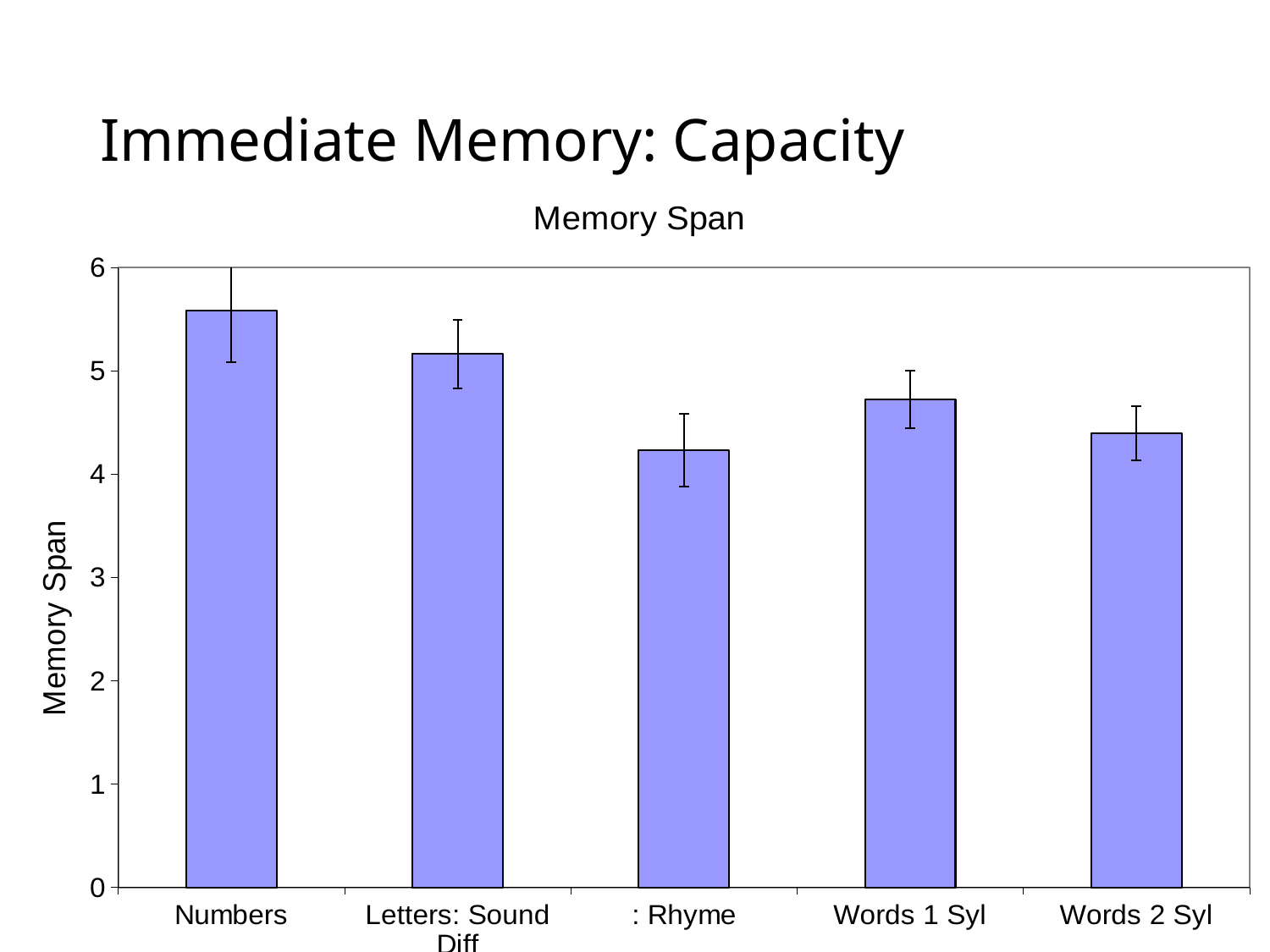
Is the memory span for : Rhyme greater or less than 5? less Which has a higher memory span, Letters: Sound Diff or : Rhyme? Letters: Sound Diff Which has a higher memory span, Words 1 Syl or Words 2 Syl? Words 1 Syl How many categories are plotted in the Memory Span chart? 5 Is the memory span for Words 2 Syl greater or less than 4? greater What is the title of the chart? Memory Span Is the memory span for Numbers greater or less than 5? greater Which category has the lowest memory span? : Rhyme Which category has the highest memory span? Numbers What kind of chart is shown on the slide? bar chart What is the label on the vertical axis of the chart? Memory Span